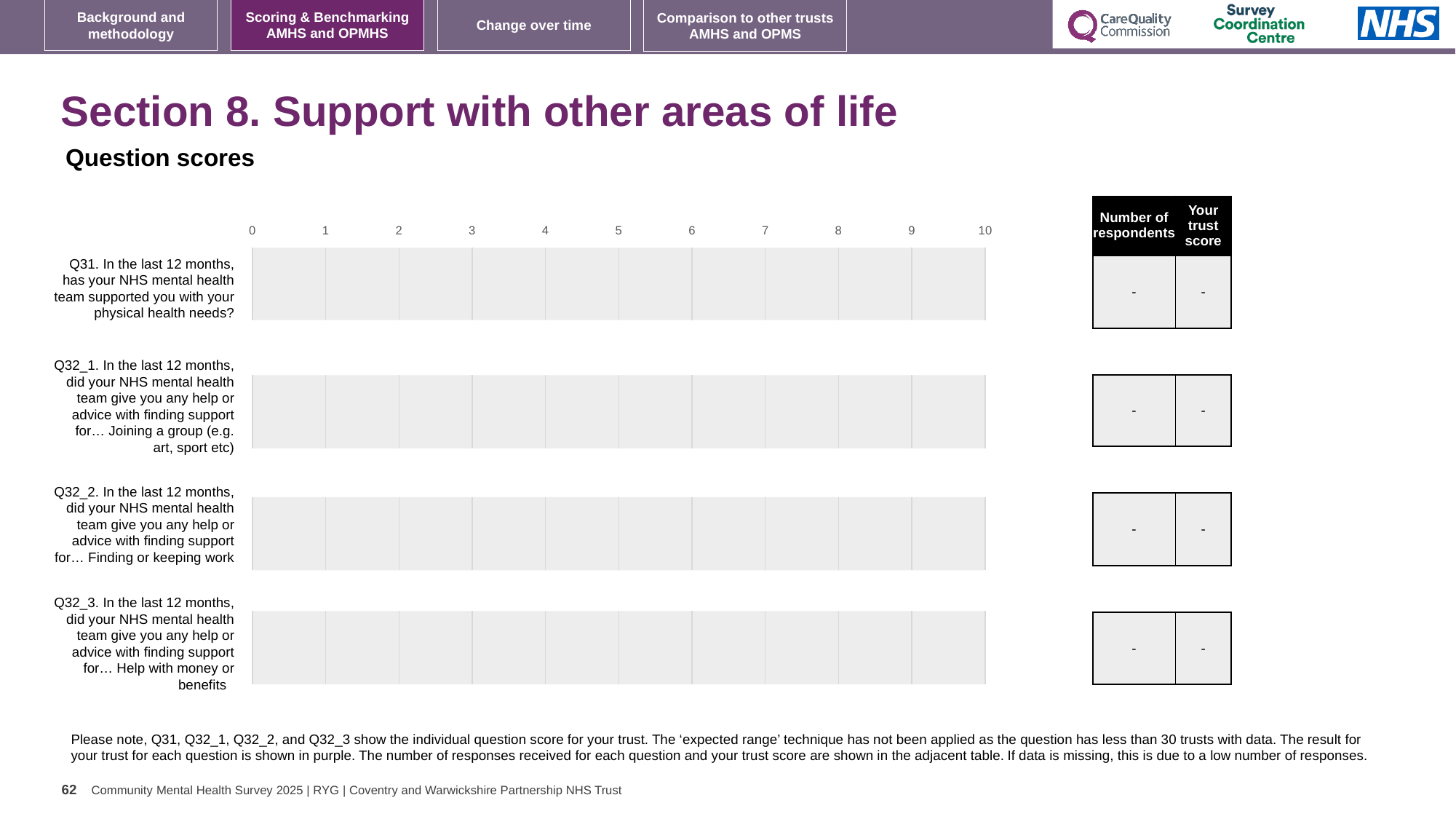
What is the lowest value shown on the chart's horizontal axis? 0 What is shown in the 'Number of respondents' column for Q32_1? - Which question label is listed last (at the bottom) on the chart? Q32_3 Which question label is listed first (at the top) on the chart? Q31 What is shown in the 'Your trust score' column for Q31? - What kind of chart is laid out on the slide? Bar chart How many tick values are printed along the chart's horizontal axis? 11 What is shown in the 'Your trust score' column for Q32_3? - What is the highest value shown on the chart's horizontal axis? 10 How many questions (categories) are listed on the chart? 4